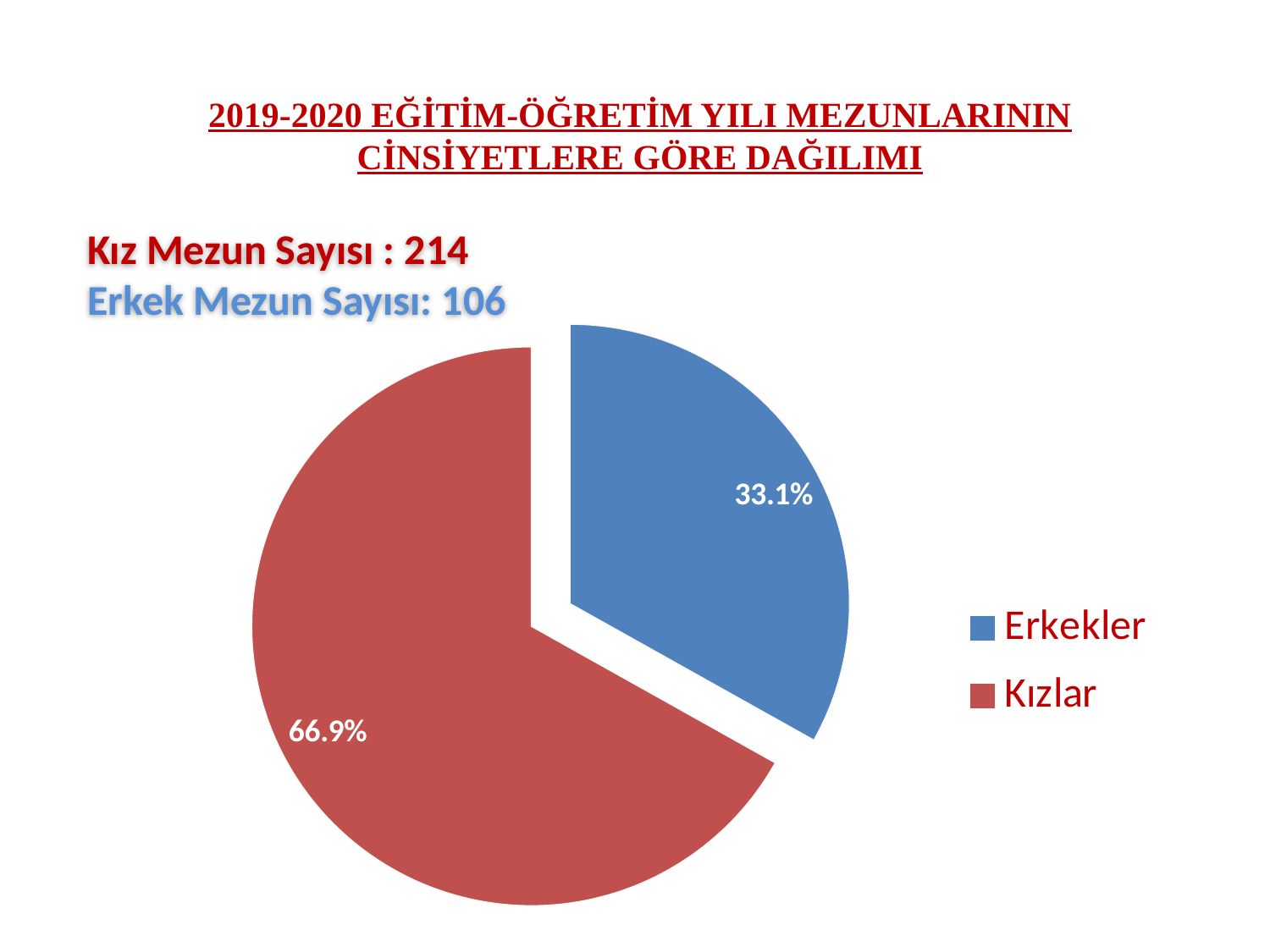
What colour is the Kızlar slice? red Which slice of the pie is the largest? Kızlar Which slice of the pie is the smallest? Erkekler What share of the pie does the Erkekler slice represent? 33.1% How many entries does the legend list? 2 What colour is the Erkekler slice? blue How many slices does the pie chart have? 2 Which is larger, the Erkekler slice or the Kızlar slice? Kızlar What share of the pie does the Kızlar slice represent? 66.9% What kind of chart is shown on the slide? pie chart What is the difference in percentage points between the Kızlar slice and the Erkekler slice? 33.8